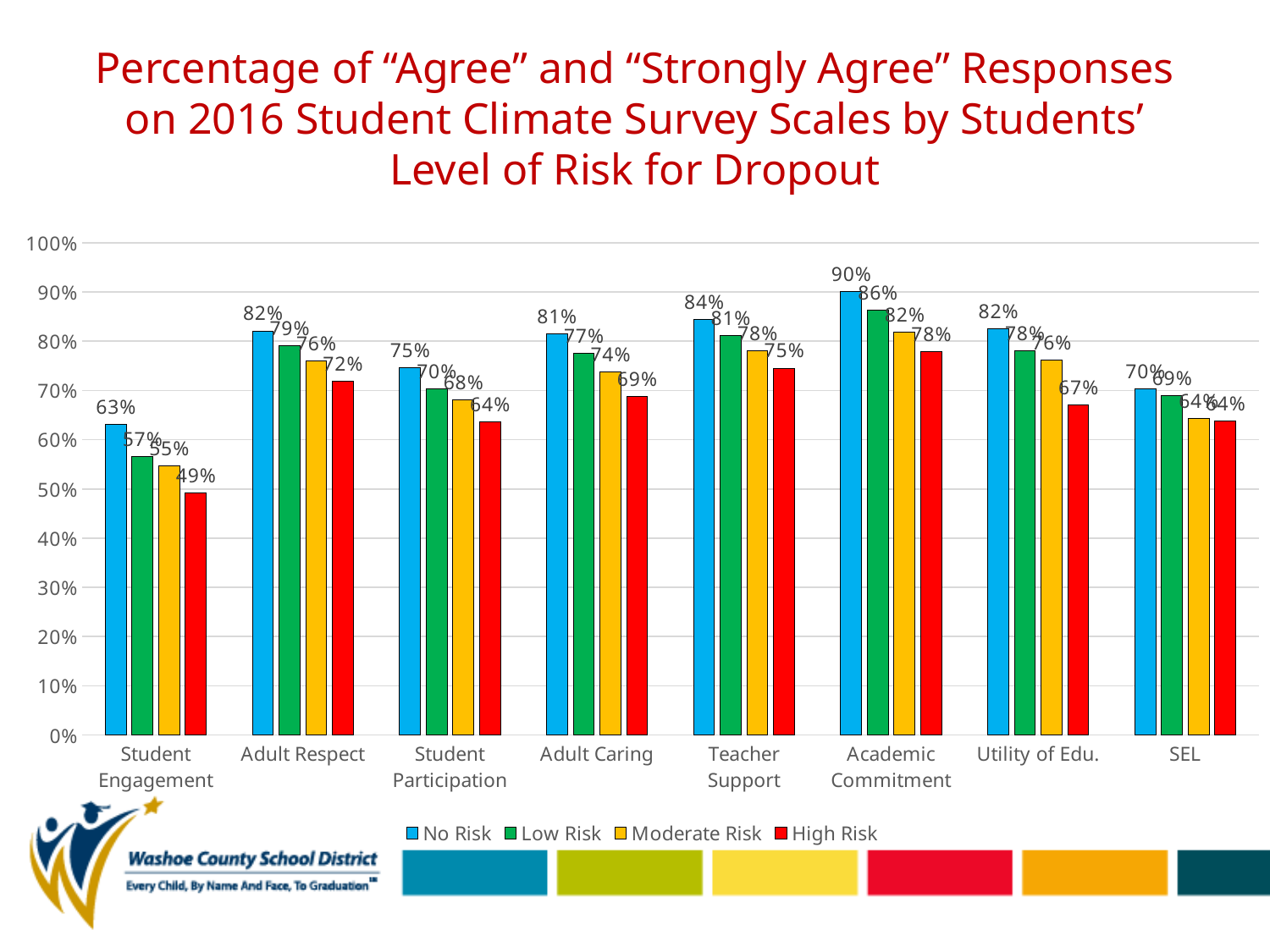
What is the High Risk value for Student Engagement? 49% Which colour represents the High Risk series in the legend? Red How many categories are shown on the x axis? 8 What is the Moderate Risk value for Adult Respect? 76% Which category has the lowest High Risk value? Student Engagement What kind of chart is shown on the slide? Bar chart What is the difference between the No Risk and High Risk values for Utility of Edu.? 15% Which is larger, the High Risk value for Teacher Support or the High Risk value for Adult Caring? Teacher Support How many series does the legend list? 4 Which category has the highest No Risk value? Academic Commitment What is the Low Risk value for Teacher Support? 81% What is the No Risk value for Academic Commitment? 90%